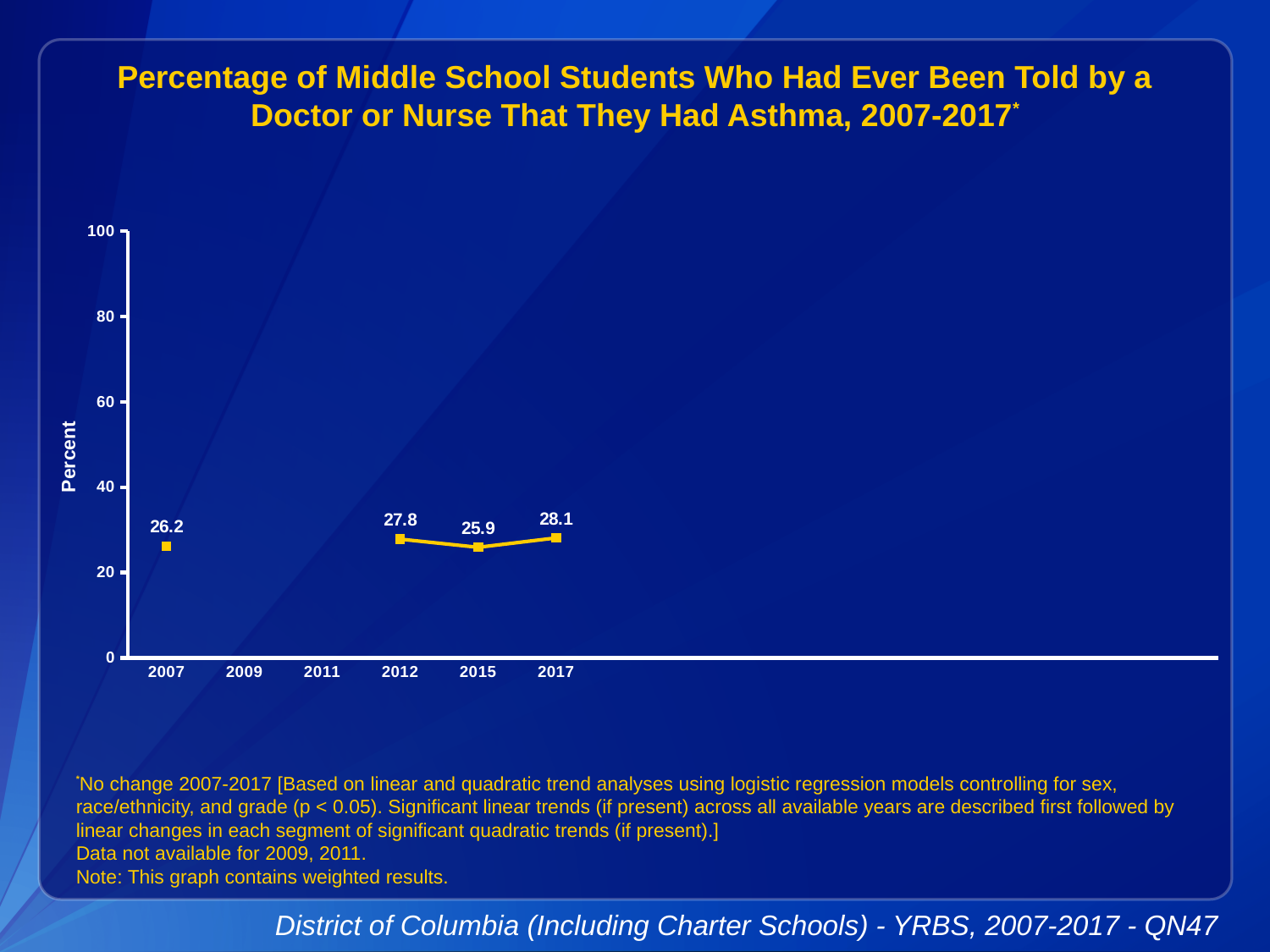
What is the value for 2007? 26.2 What is the value for 2012? 27.8 What is the value for 2017? 28.1 Is the value for 2017 greater or less than 40? less What is the label on the y axis? Percent Which year has the lowest value? 2015 How many years have data points plotted on the chart? 4 What kind of chart is shown? line chart What is the difference between the values for 2017 and 2015? 2.2 Which year has the highest value? 2017 What is the value for 2015? 25.9 Which is larger, the value for 2012 or the value for 2007? 2012